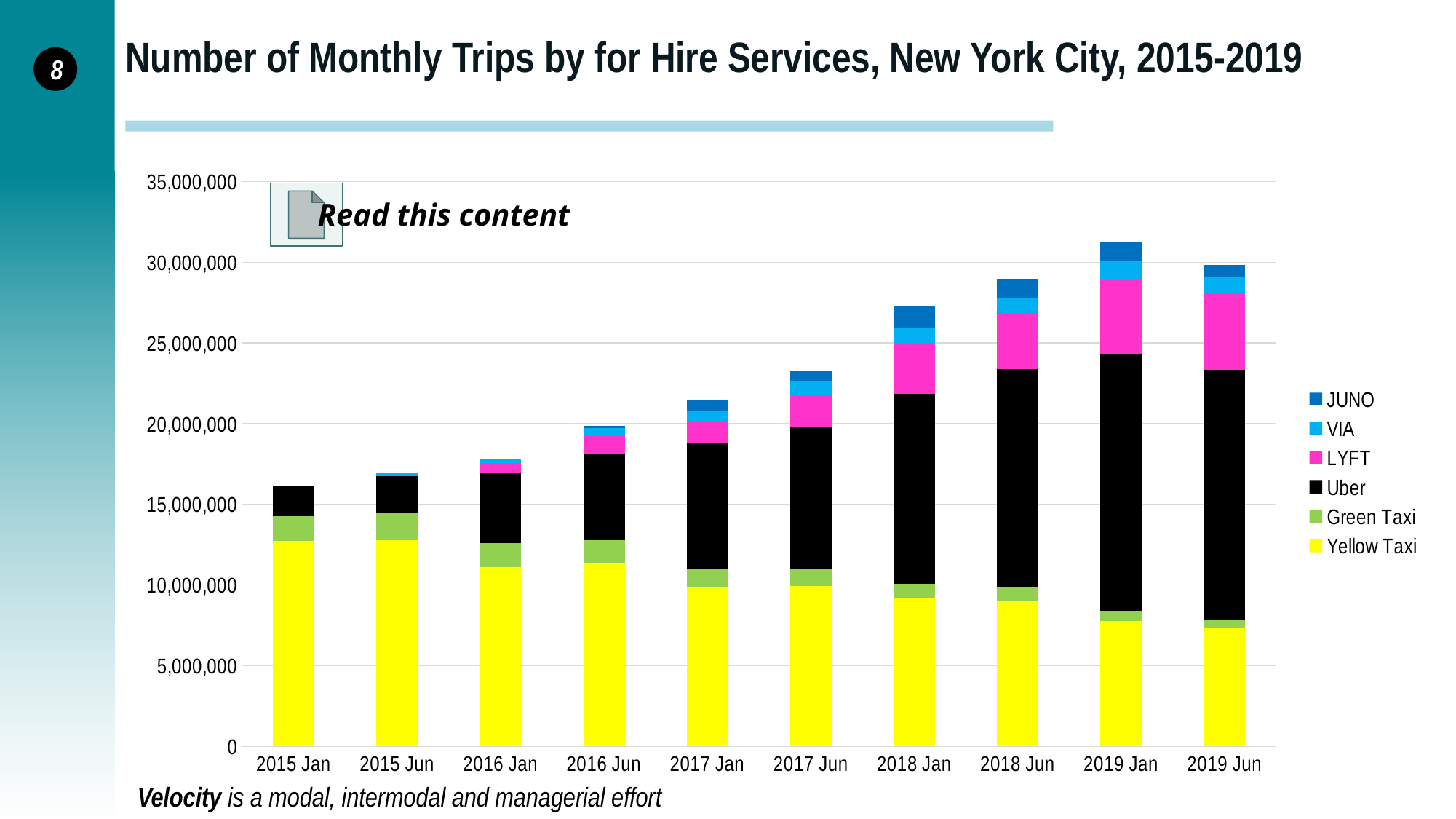
Which period has the lowest total number of monthly trips? 2015 Jan Is the total number of trips for 2015 Jan greater or less than 20,000,000? less Is the total number of trips for 2019 Jan greater or less than 30,000,000? greater Is the Yellow Taxi value for 2019 Jun greater or less than 10,000,000? less What kind of chart is shown on the slide? Stacked bar chart Which series is shown in black in the legend? Uber Which period has the highest total number of monthly trips? 2019 Jan Which has the larger Yellow Taxi value, 2015 Jan or 2019 Jun? 2015 Jan Which has the larger total number of trips, 2017 Jan or 2018 Jan? 2018 Jan How many time periods (bars) are shown on the x axis? 10 How many series does the legend list? 6 Do the Yellow Taxi values rise or fall from 2015 Jan to 2019 Jun? fall